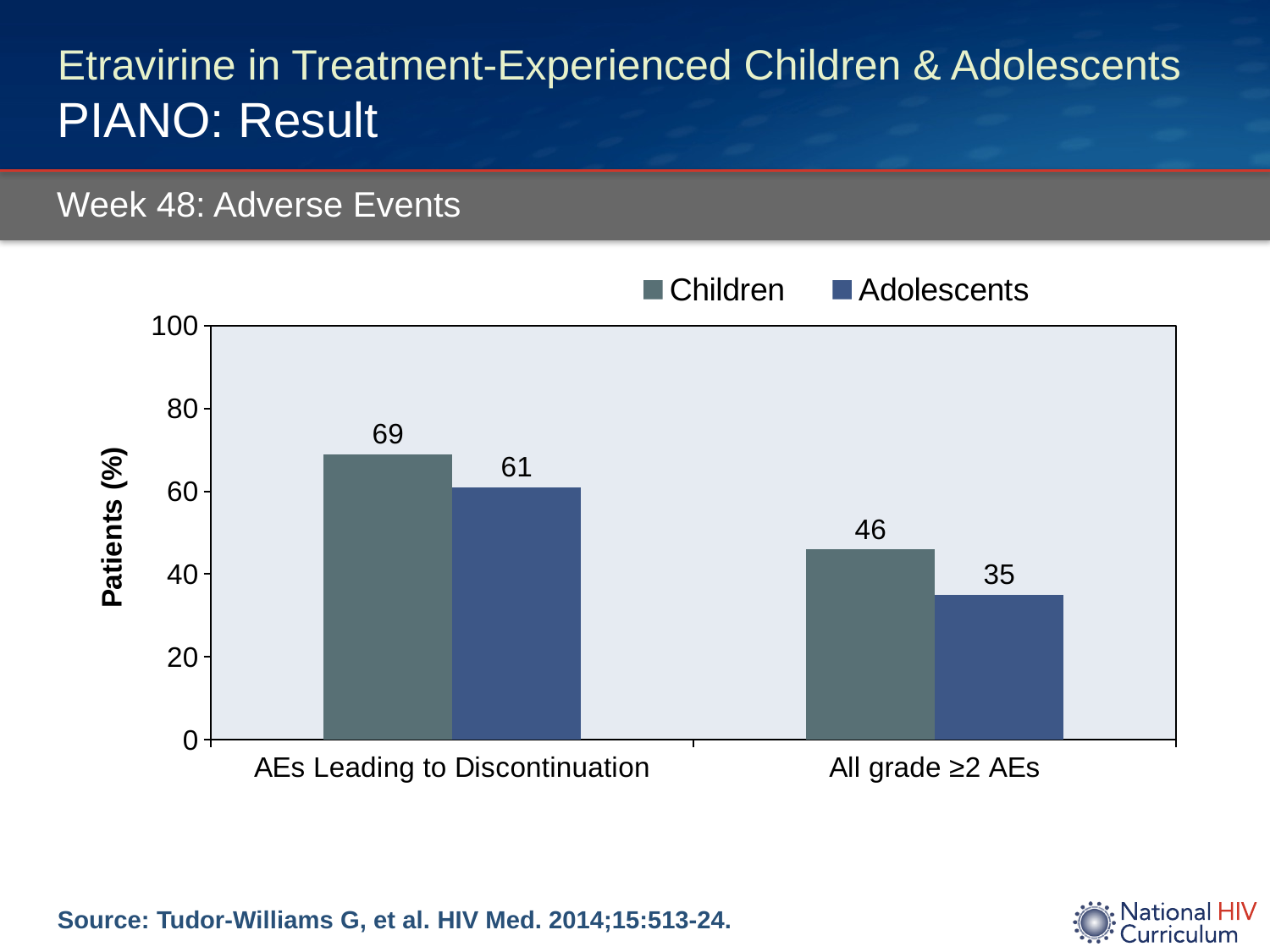
What kind of chart is shown on the slide? Bar chart What percentage of adolescents had AEs leading to discontinuation? 61 How many series does the legend list? 2 What is the difference between children and adolescents for all grade ≥2 AEs? 11 Which group and category has the highest value on the chart? Children, AEs Leading to Discontinuation What percentage of adolescents had all grade ≥2 AEs? 35 Which group and category has the lowest value on the chart? Adolescents, All grade ≥2 AEs What percentage of children had AEs leading to discontinuation? 69 For all grade ≥2 AEs, which group has the higher value, children or adolescents? Children What is the difference between children and adolescents for AEs leading to discontinuation? 8 What is the label of the y axis? Patients (%) What percentage of children had all grade ≥2 AEs? 46